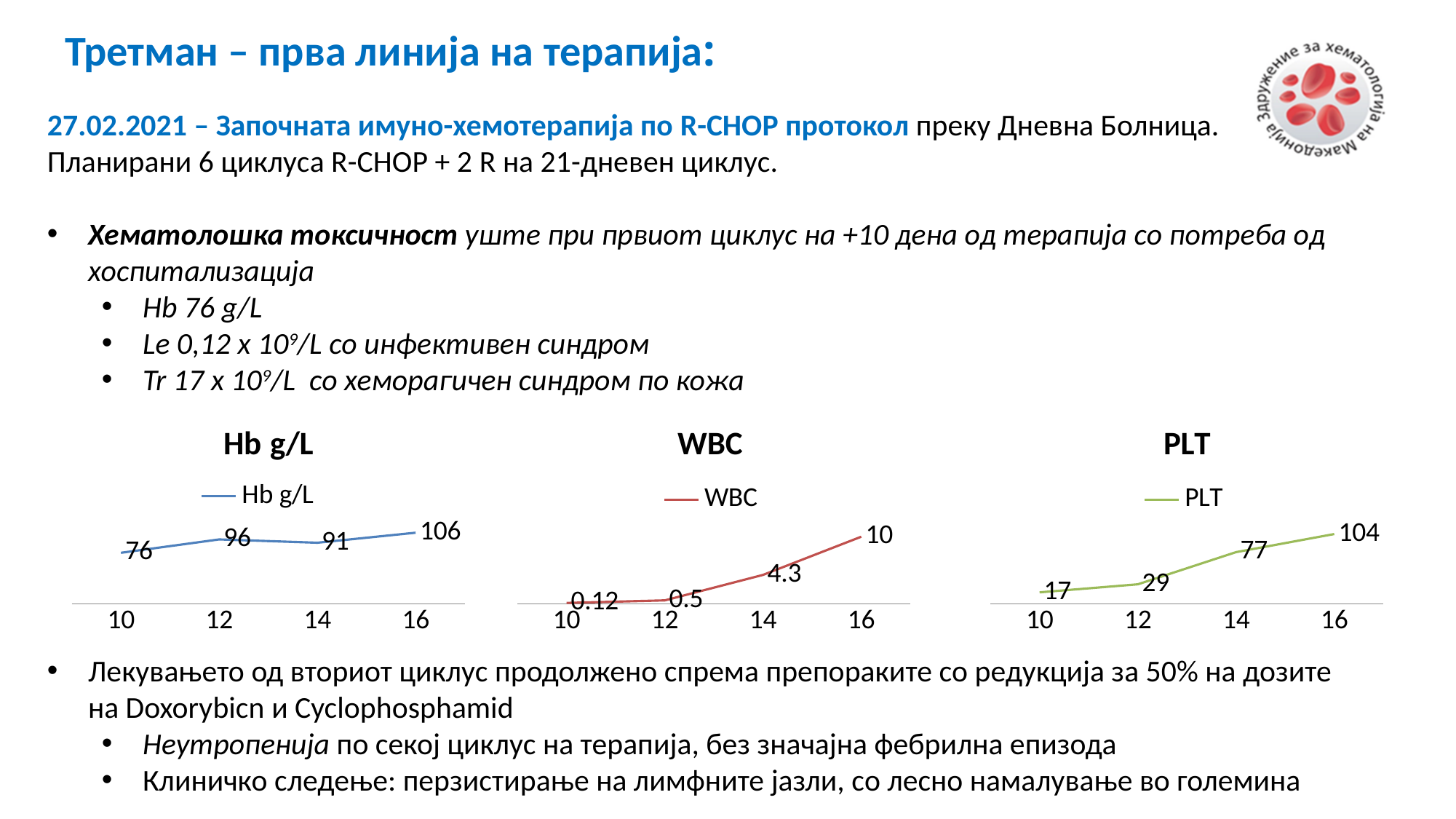
In the Hb g/L chart, what is the value at x = 16? 106 In the PLT chart, what is the difference between the values at x = 16 and x = 10? 87 In the PLT chart, what is the value at x = 12? 29 In the WBC chart, what is the value at x = 14? 4.3 In the PLT chart, do the values rise or fall from x = 10 to x = 16? rise How many data points are plotted in the WBC chart? 4 In the Hb g/L chart, at which x value is the plotted value lowest? 10 What kind of chart is the PLT chart? line chart In the PLT chart, at which x value is the plotted value highest? 16 In the WBC chart, what is the difference between the values at x = 16 and x = 12? 9.5 In the Hb g/L chart, what is the value at x = 10? 76 In the Hb g/L chart, which is larger: the value at x = 12 or the value at x = 14? x = 12